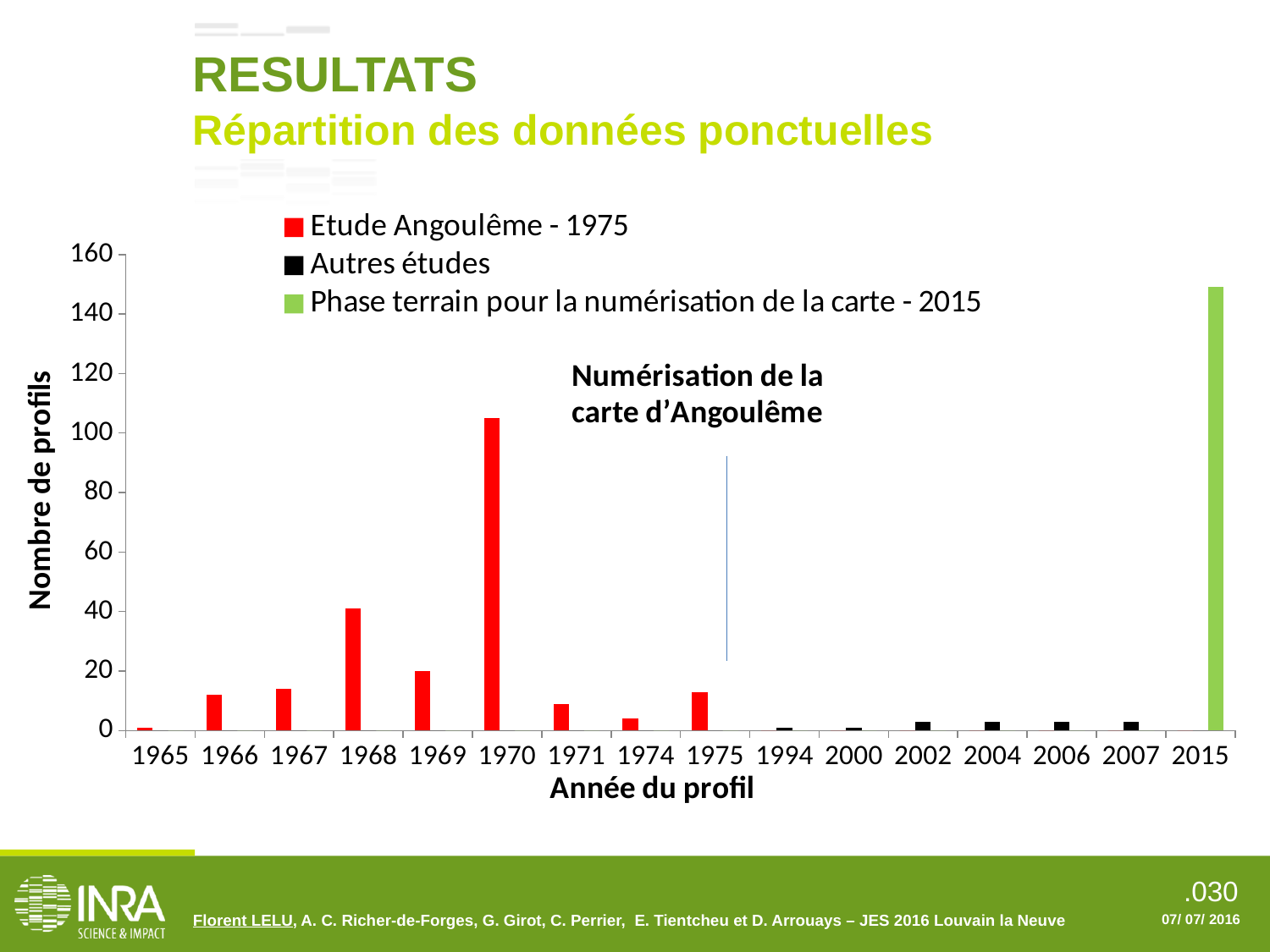
Which year has the larger value, 1968 or 1969? 1968 Which year has the highest number of profiles? 2015 Is the value for 2015 greater or less than 140? greater Is the value for 1968 greater or less than 60? less How many series does the legend list? 3 Which year has the larger value, 1970 or 1968? 1970 Is the value for 1966 greater or less than 20? less What is the label of the y axis? Nombre de profils How many years are shown on the x axis? 16 What kind of chart is shown on the slide? bar chart